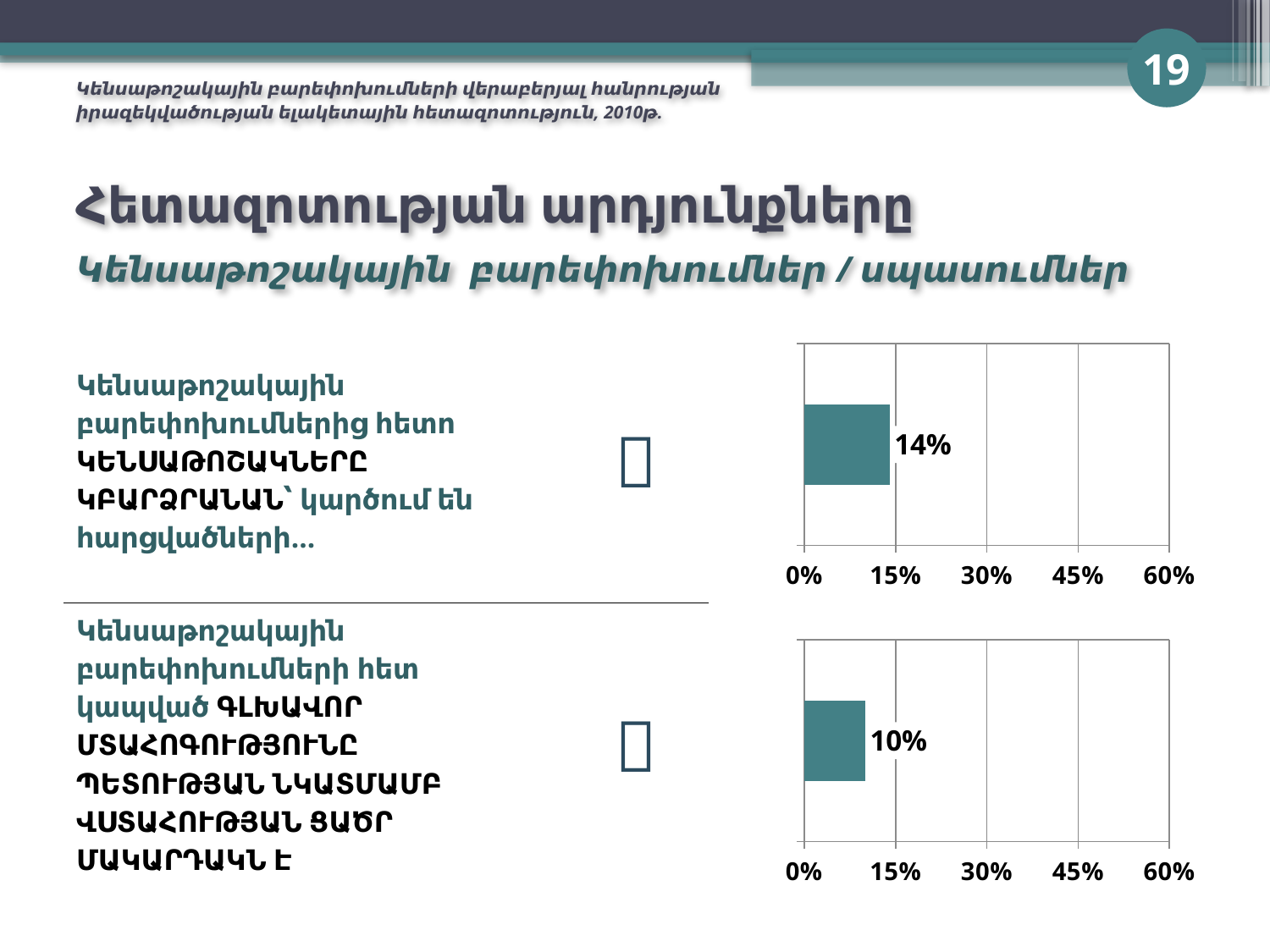
Which chart shows the larger value, the top chart or the bottom chart? The top chart How many bars are plotted in the top chart on the right? 1 How many bars are plotted in the bottom chart on the right? 1 Are the bars in the two charts on the right oriented horizontally or vertically? Horizontally In the top chart on the right, is the bar's value greater or less than 15%? less In the bottom chart on the right, is the bar's value greater or less than 15%? less What is the highest value shown on the x axis of the top chart on the right? 60% In the bottom chart on the right, what value is shown on the bar? 10% What kind of chart is the top chart on the right? Bar chart In the top chart on the right, what value is shown on the bar? 14% What is the difference between the value in the top chart (14%) and the value in the bottom chart (10%)? 4 percentage points What kind of chart is the bottom chart on the right? Bar chart